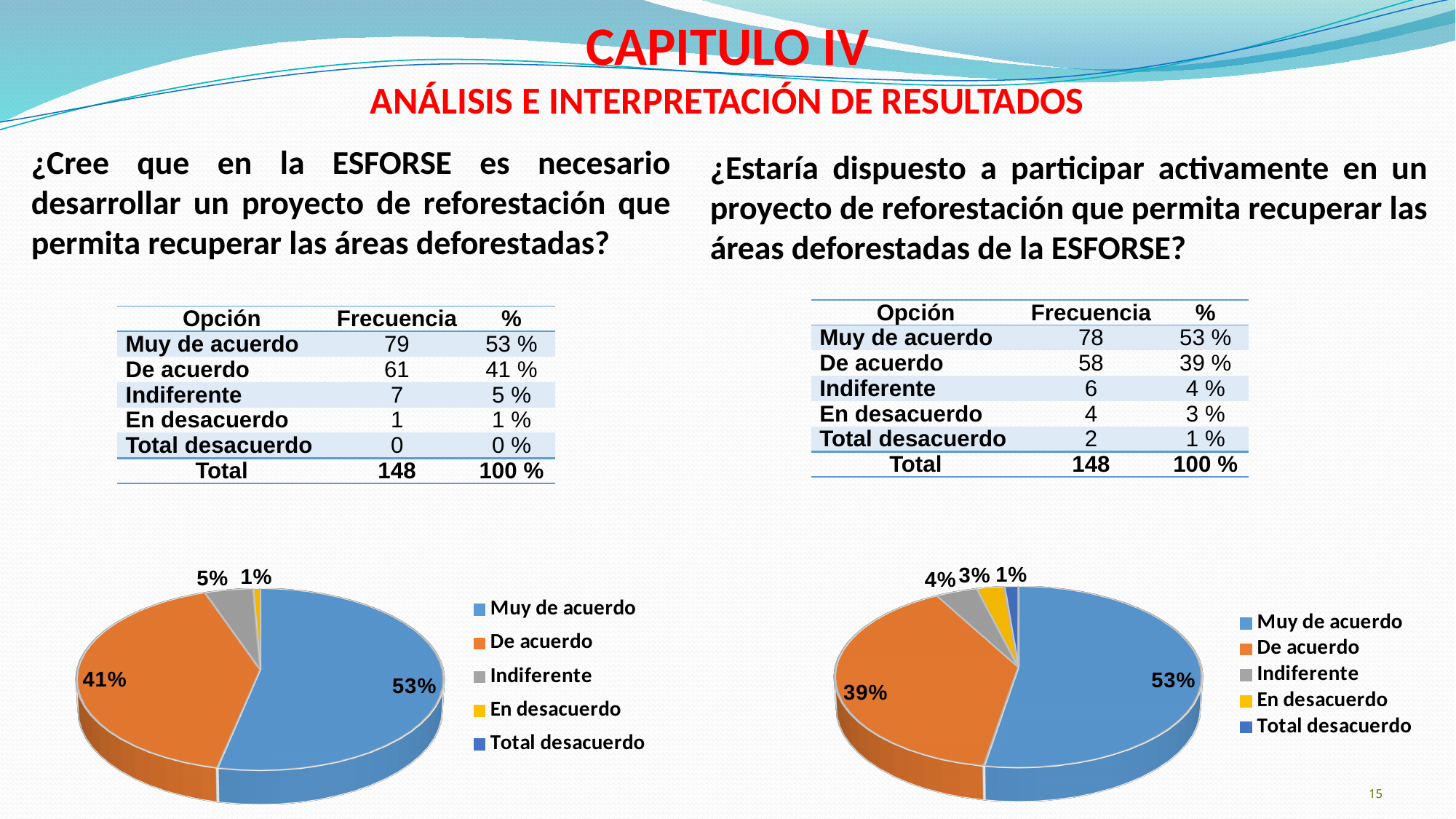
In the left pie chart, which category has the largest slice? Muy de acuerdo How many entries does the legend of the left pie chart list? 5 In the right pie chart, which colour represents Indiferente? Grey In the right pie chart, which category has the smallest labelled slice? Total desacuerdo In the left pie chart, what share is labelled for Muy de acuerdo? 53% What kind of chart is shown on the left side of the slide? Pie chart In the left pie chart, what share is labelled for De acuerdo? 41% In the right pie chart, what share is labelled for De acuerdo? 39% In the right pie chart, what share is labelled for En desacuerdo? 3% In the right pie chart, what is the difference between the Muy de acuerdo and De acuerdo shares? 14% In the right pie chart, what share is labelled for Total desacuerdo? 1% In the left pie chart, what share is labelled for Indiferente? 5%